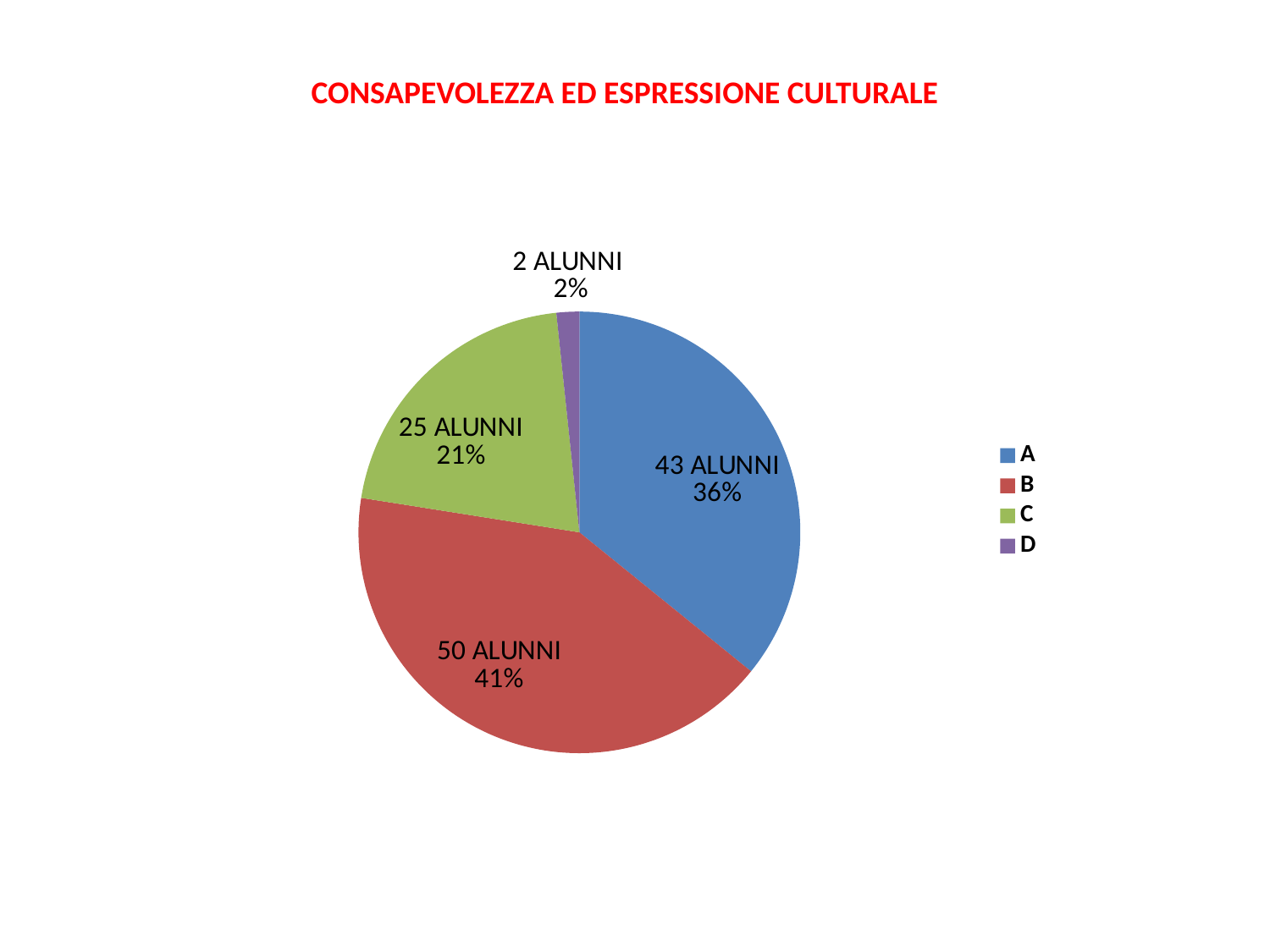
How many alunni are in category A? 43 ALUNNI How many alunni are in category B? 50 ALUNNI How many alunni are in category D? 2 ALUNNI How many alunni are in category C? 25 ALUNNI What type of chart is shown on the slide? pie chart What share of the pie does category B represent? 41% How many entries does the legend list? 4 How many slices does the pie chart have? 4 Which category has the smallest slice? D What is the title of the chart? CONSAPEVOLEZZA ED ESPRESSIONE CULTURALE Which category has the largest slice? B What share of the pie does category D represent? 2%